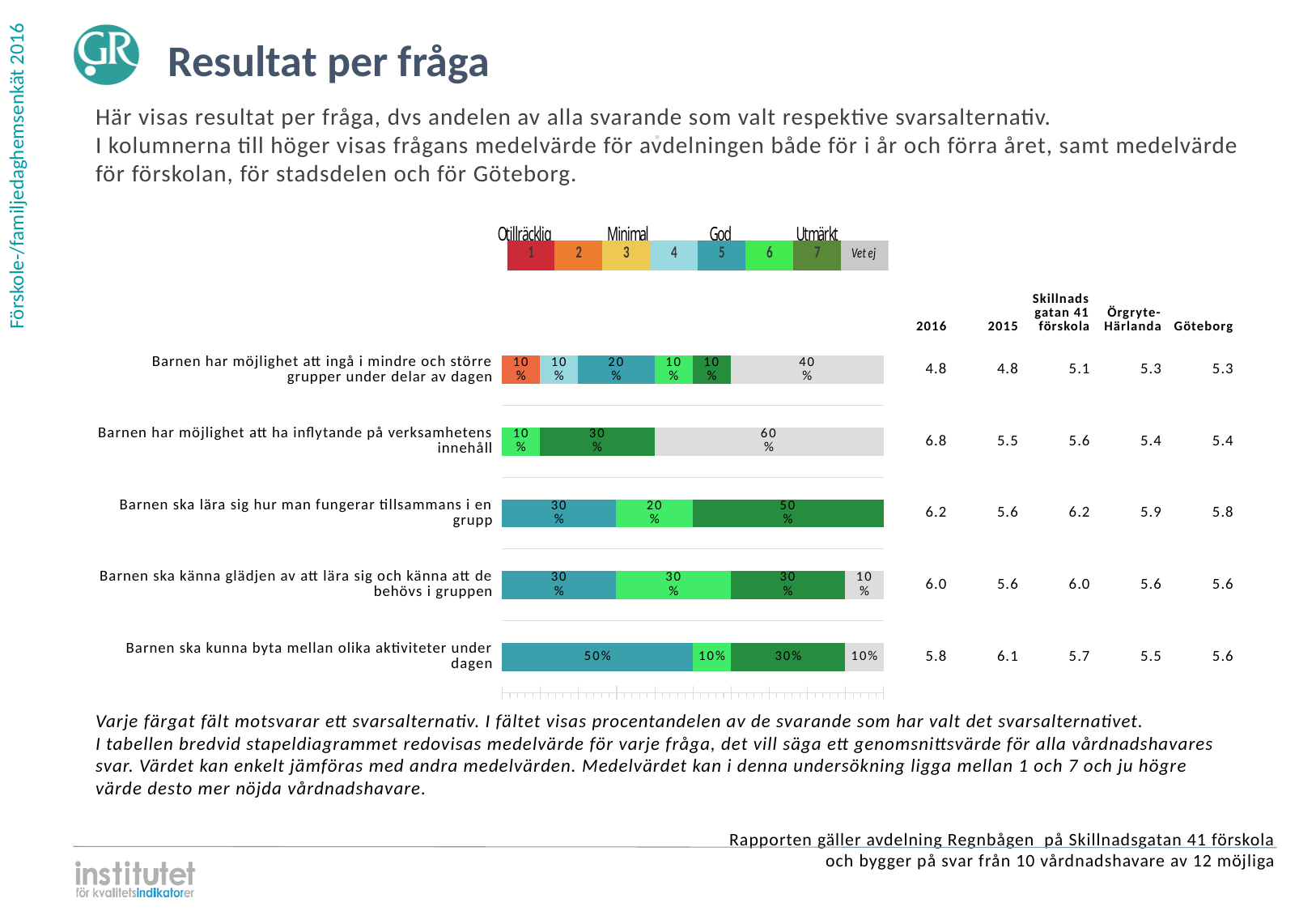
What percentage chose answer 5 for 'Barnen ska kunna byta mellan olika aktiviteter under dagen'? 50% Which question has the largest 'Vet ej' share? Barnen har möjlighet att ha inflytande på verksamhetens innehåll What percentage chose answer 7 (Utmärkt) for 'Barnen ska lära sig hur man fungerar tillsammans i en grupp'? 50% What is the 2016 mean value for 'Barnen har möjlighet att ha inflytande på verksamhetens innehåll'? 6.8 What is the difference between the 'Vet ej' share for 'Barnen har möjlighet att ingå i mindre och större grupper under delar av dagen' and for 'Barnen ska kunna byta mellan olika aktiviteter under dagen'? 30% What kind of chart is shown on the slide? Stacked bar chart What percentage of respondents answered 'Vet ej' for 'Barnen har möjlighet att ha inflytande på verksamhetens innehåll'? 60% Which is larger: the answer 7 share for 'Barnen ska lära sig hur man fungerar tillsammans i en grupp' or for 'Barnen ska kunna byta mellan olika aktiviteter under dagen'? Barnen ska lära sig hur man fungerar tillsammans i en grupp How many answer alternatives does the legend above the chart list? 8 What is the total of the stacked bar for 'Barnen ska känna glädjen av att lära sig och känna att de behövs i gruppen'? 100% How many questions (categories) are plotted in the bar chart? 5